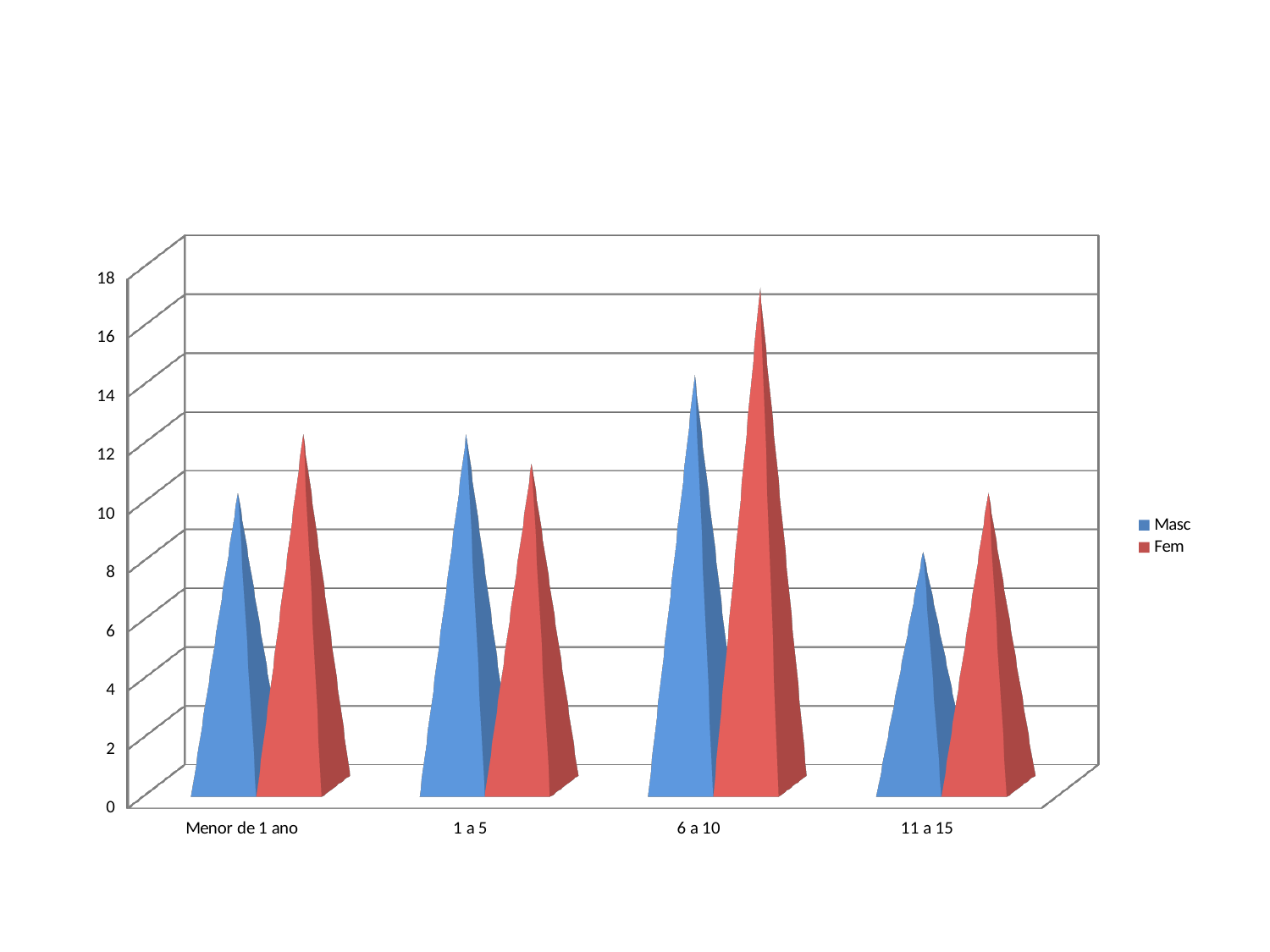
What kind of chart is shown on the slide? bar chart What are the two series named in the legend? Masc and Fem Which category has the highest Fem value? 6 a 10 Is the Masc value for 6 a 10 greater or less than 12? greater How many age categories are shown on the x axis? 4 How many series does the legend list? 2 Is the Masc value for 11 a 15 greater or less than 10? less In the Menor de 1 ano category, which series has the larger value, Masc or Fem? Fem Which category has the highest Masc value? 6 a 10 Which category has the lowest Masc value? 11 a 15 Is the Fem value for 6 a 10 greater or less than 14? greater In the 6 a 10 category, which series has the larger value, Masc or Fem? Fem